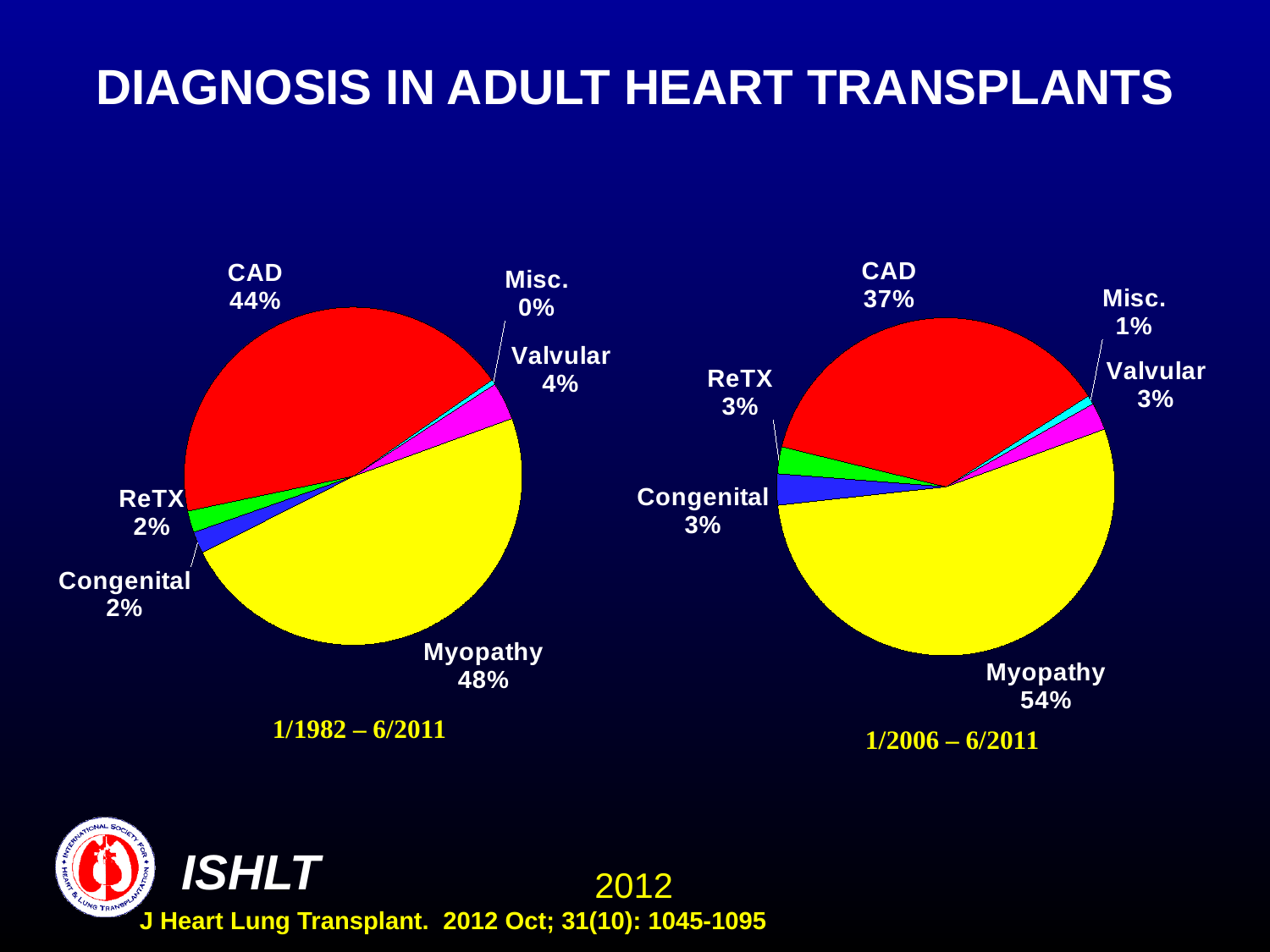
In the right pie chart (1/2006 – 6/2011), which diagnosis has the largest share? Myopathy What type of chart is used on this slide to show diagnosis in adult heart transplants? Pie chart In the left pie chart (1/1982 – 6/2011), what percentage is labelled for Valvular? 4% In the left pie chart (1/1982 – 6/2011), which diagnosis has the smallest share? Misc. What time period does the left pie chart cover? 1/1982 – 6/2011 In the left pie chart (1/1982 – 6/2011), what is the difference between the Myopathy share and the CAD share? 4% Which is larger in the left pie chart (1/1982 – 6/2011): the share for CAD or the share for Myopathy? Myopathy In the right pie chart (1/2006 – 6/2011), what is the difference between the Myopathy share and the CAD share? 17% In the right pie chart (1/2006 – 6/2011), what percentage is labelled for Misc.? 1% In the right pie chart (1/2006 – 6/2011), what share of adult heart transplants is for CAD? 37% How many diagnosis categories are shown in the right pie chart (1/2006 – 6/2011)? 6 In the left pie chart (1/1982 – 6/2011), what share of adult heart transplants is for Myopathy? 48%